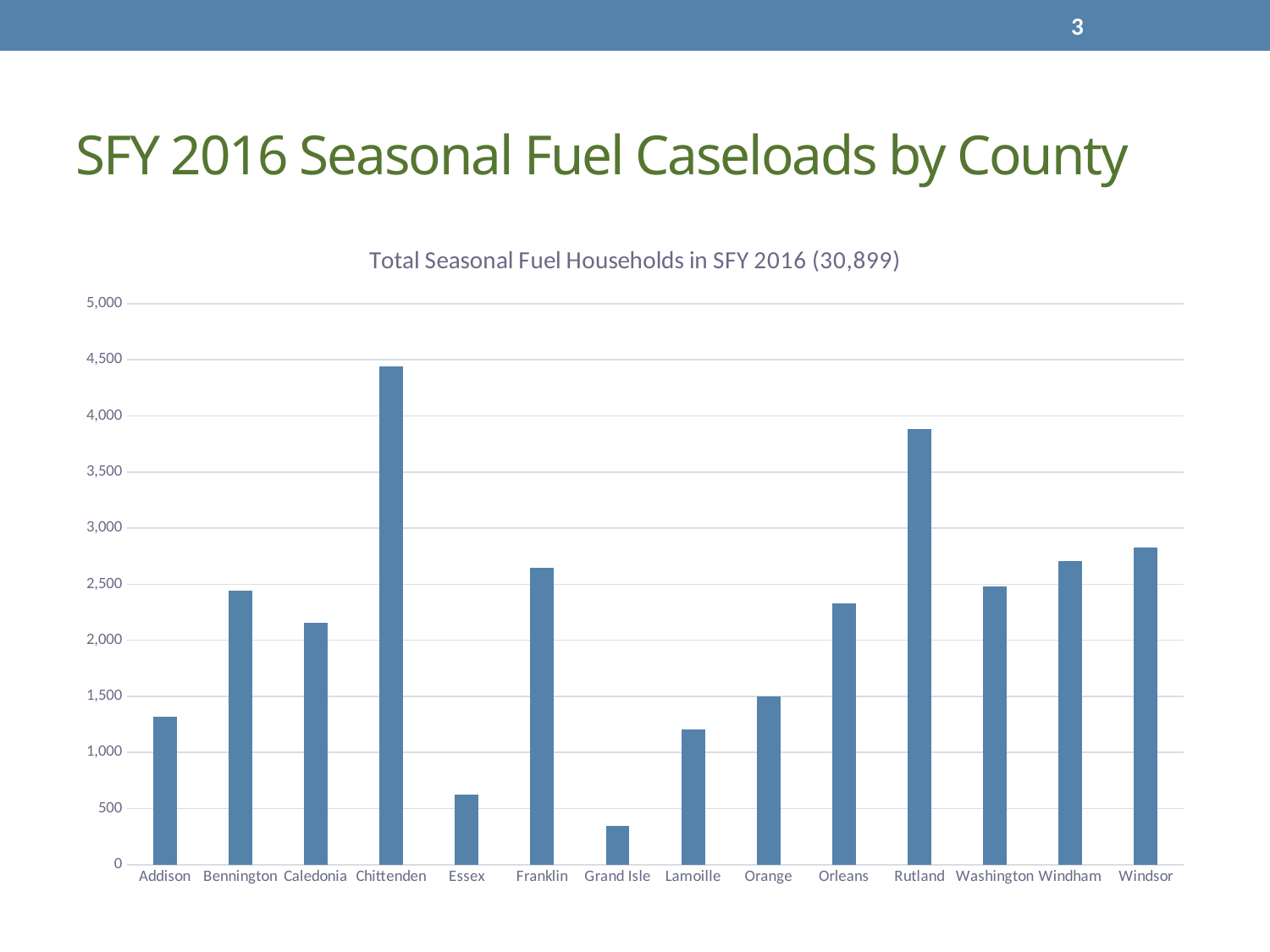
What kind of chart is shown on the slide? bar chart Is the value for Essex greater or less than 1,000? less Is the value for Rutland greater or less than 3,500? greater Is the value for Chittenden greater or less than 4,000? greater How many counties are shown on the x axis of the chart? 14 What total number of seasonal fuel households is given in the chart title? 30,899 Which county has the lowest number of seasonal fuel households? Grand Isle Which county has more seasonal fuel households, Franklin or Orleans? Franklin Which county has more seasonal fuel households, Chittenden or Rutland? Chittenden Which county has the highest number of seasonal fuel households? Chittenden